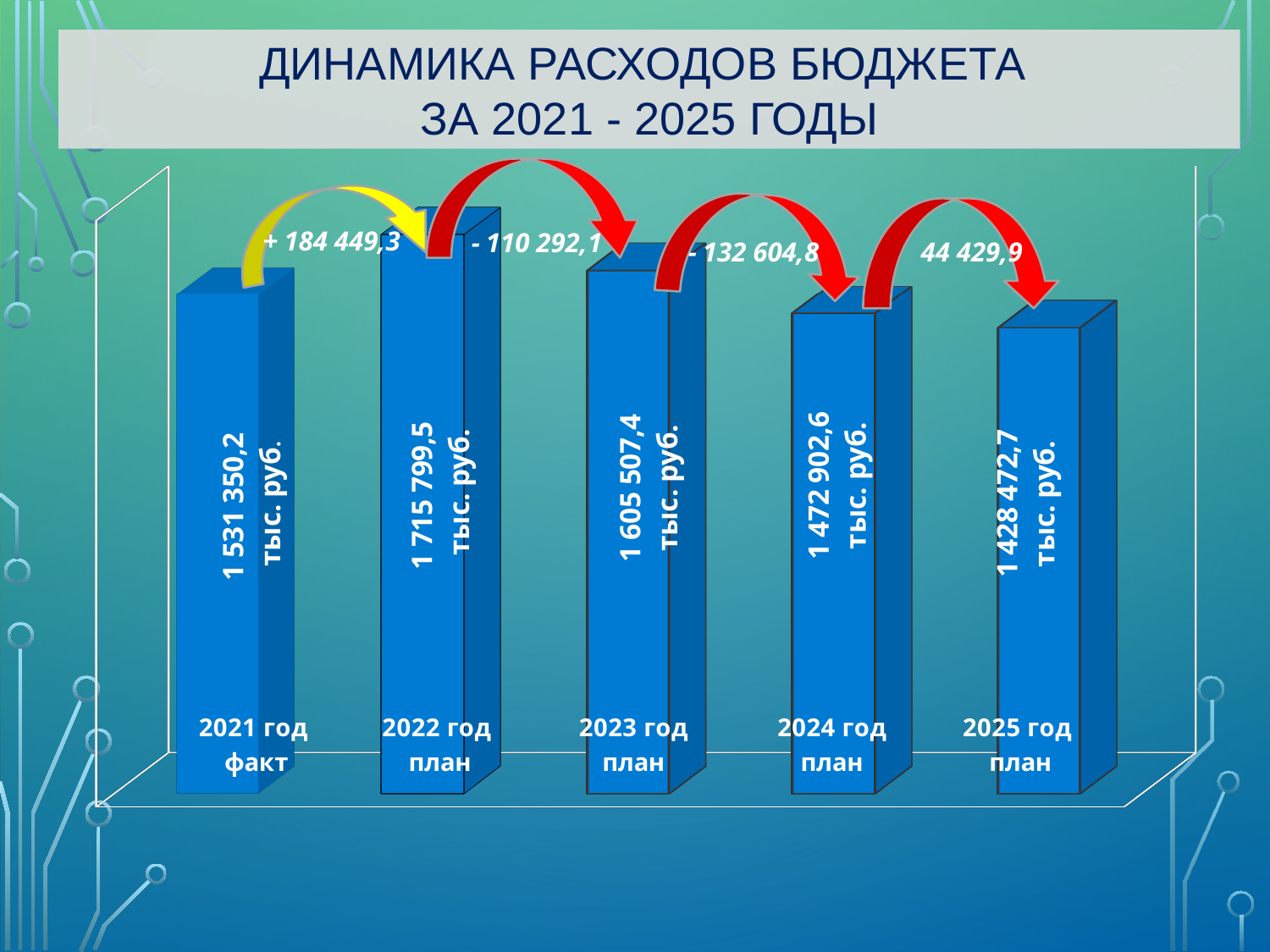
What is the difference between the 2022 год план value and the 2021 год факт value? 184 449,3 What kind of chart is shown on the slide? Bar chart What is the title of the chart on the slide? ДИНАМИКА РАСХОДОВ БЮДЖЕТА ЗА 2021 - 2025 ГОДЫ How many years (bars) are shown on the chart? 5 Which year has the highest budget expenditure value on the chart? 2022 год план What is the planned budget expenditure shown for 2022 год план? 1 715 799,5 тыс. руб. What is the budget expenditure value shown for 2021 год факт? 1 531 350,2 тыс. руб. Which is larger: the value for 2023 год план or the value for 2024 год план? 2023 год план Which year has the lowest budget expenditure value on the chart? 2025 год план By how much does the value for 2024 год план differ from the value for 2023 год план? 132 604,8 Do the values rise or fall from 2022 год план to 2025 год план? Fall What is the planned budget expenditure shown for 2025 год план? 1 428 472,7 тыс. руб.